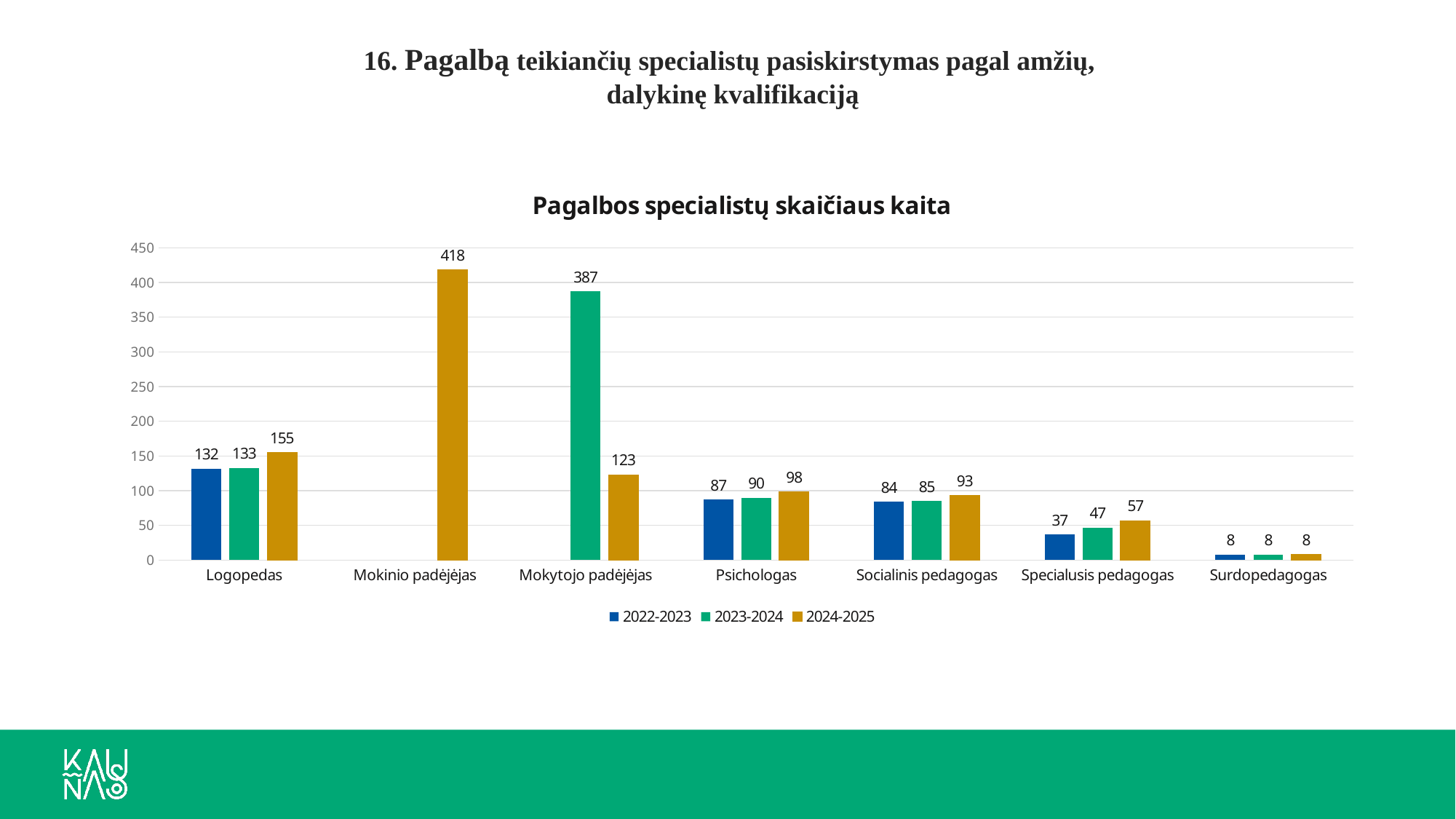
What is the value for Specialusis pedagogas in the 2022-2023 series? 37 What is the difference between the 2024-2025 and 2022-2023 values for Logopedas? 23 Which category has the highest value in the 2024-2025 series? Mokinio padėjėjas Which is larger: the 2023-2024 value for Mokytojo padėjėjas or the 2024-2025 value for Mokinio padėjėjas? 2024-2025 value for Mokinio padėjėjas What is the value for Mokytojo padėjėjas in the 2023-2024 series? 387 What kind of chart is shown? bar chart Which category has the lowest value in the 2023-2024 series? Surdopedagogas How many categories are shown on the x axis? 7 Is the 2024-2025 value for Psichologas greater or less than 100? less How many series does the legend list? 3 What is the value for Logopedas in the 2024-2025 series? 155 What is the title of the chart? Pagalbos specialistų skaičiaus kaita